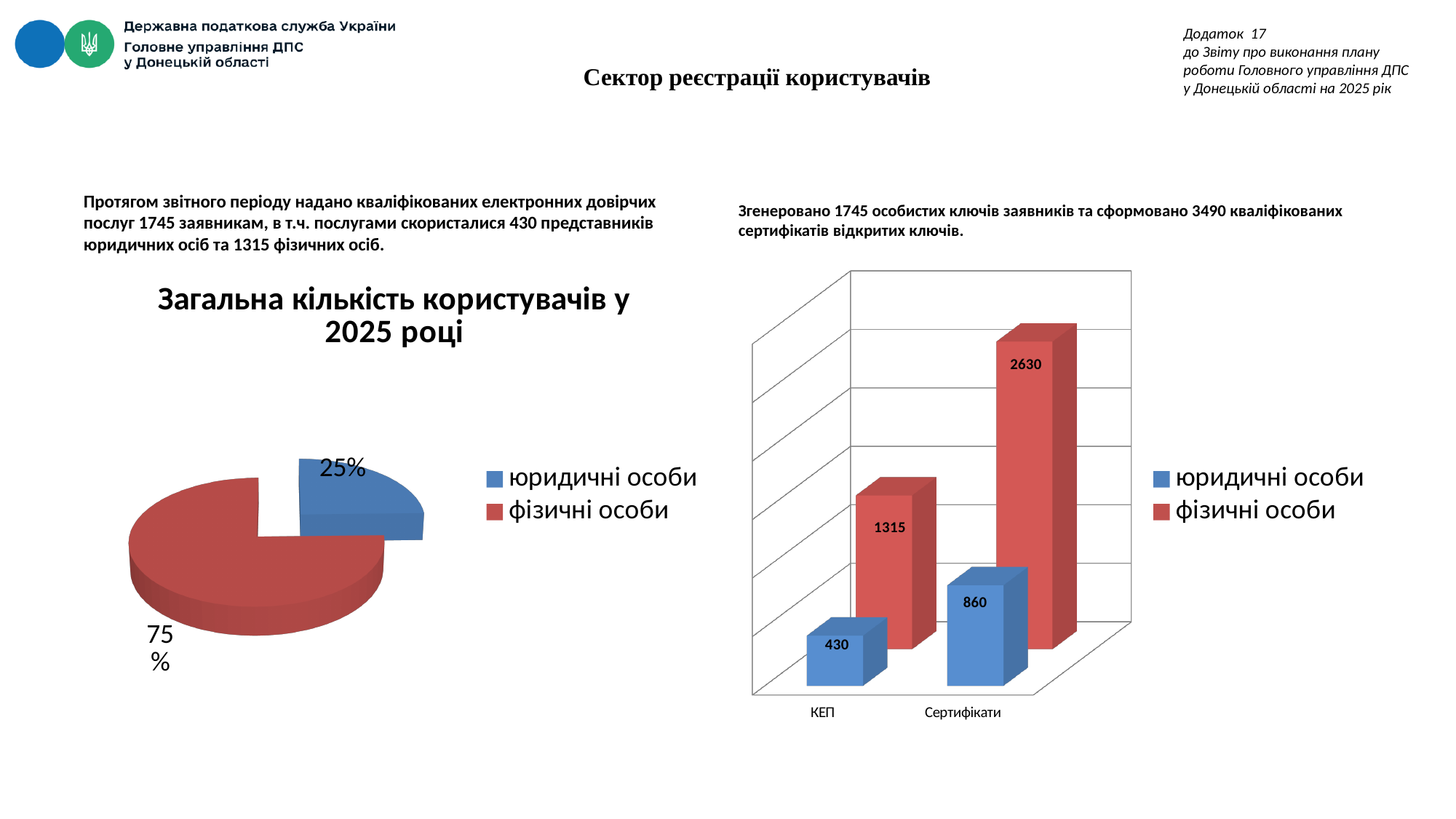
What type of chart is the chart on the right of the slide? bar chart How many slices does the pie chart 'Загальна кількість користувачів у 2025 році' have? 2 What type of chart is the chart on the left of the slide? pie chart In the bar chart on the right of the slide, what is the value for фізичні особи in the Сертифікати category? 2630 In the pie chart 'Загальна кількість користувачів у 2025 році', what share do фізичні особи have? 75% In the pie chart 'Загальна кількість користувачів у 2025 році', which category has the larger slice? фізичні особи In the bar chart on the right of the slide, what is the value for фізичні особи in the КЕП category? 1315 In the bar chart on the right of the slide, what is the value for юридичні особи in the КЕП category? 430 In the bar chart on the right of the slide, what is the difference between фізичні особи and юридичні особи in the Сертифікати category? 1770 How many series does the legend of the bar chart on the right of the slide list? 2 In the pie chart 'Загальна кількість користувачів у 2025 році', what share do юридичні особи have? 25% In the bar chart on the right of the slide, which bar is the highest? фізичні особи, Сертифікати